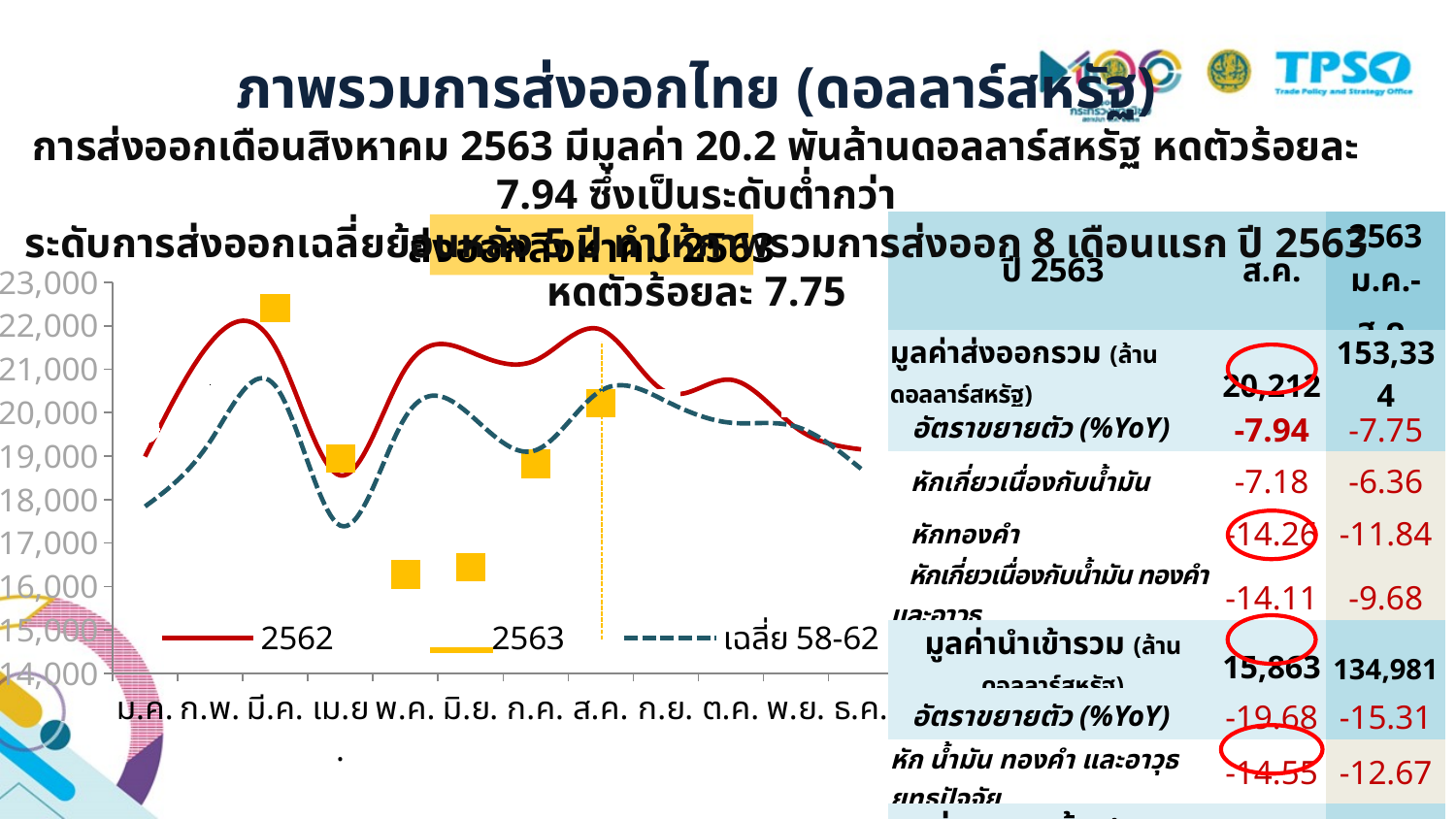
Is the เฉลี่ย 58-62 value for เม.ย. greater or less than 18,000? less Does the 2563 series rise or fall from มี.ค. to เม.ย.? fall Is the 2563 value for มี.ค. greater or less than 22,000? greater Is the 2563 value for พ.ค. greater or less than 17,000? less What is the highest value shown on the chart's y axis? 23,000 Which is larger for the 2563 series: the value for มี.ค. or the value for เม.ย.? มี.ค. How many series does the chart legend list? 3 What are the three series listed in the chart legend? 2562, 2563, เฉลี่ย 58-62 What kind of chart is shown on the slide? line chart How many months are shown along the x axis of the chart? 12 Which month has the highest value for the 2563 series? มี.ค.